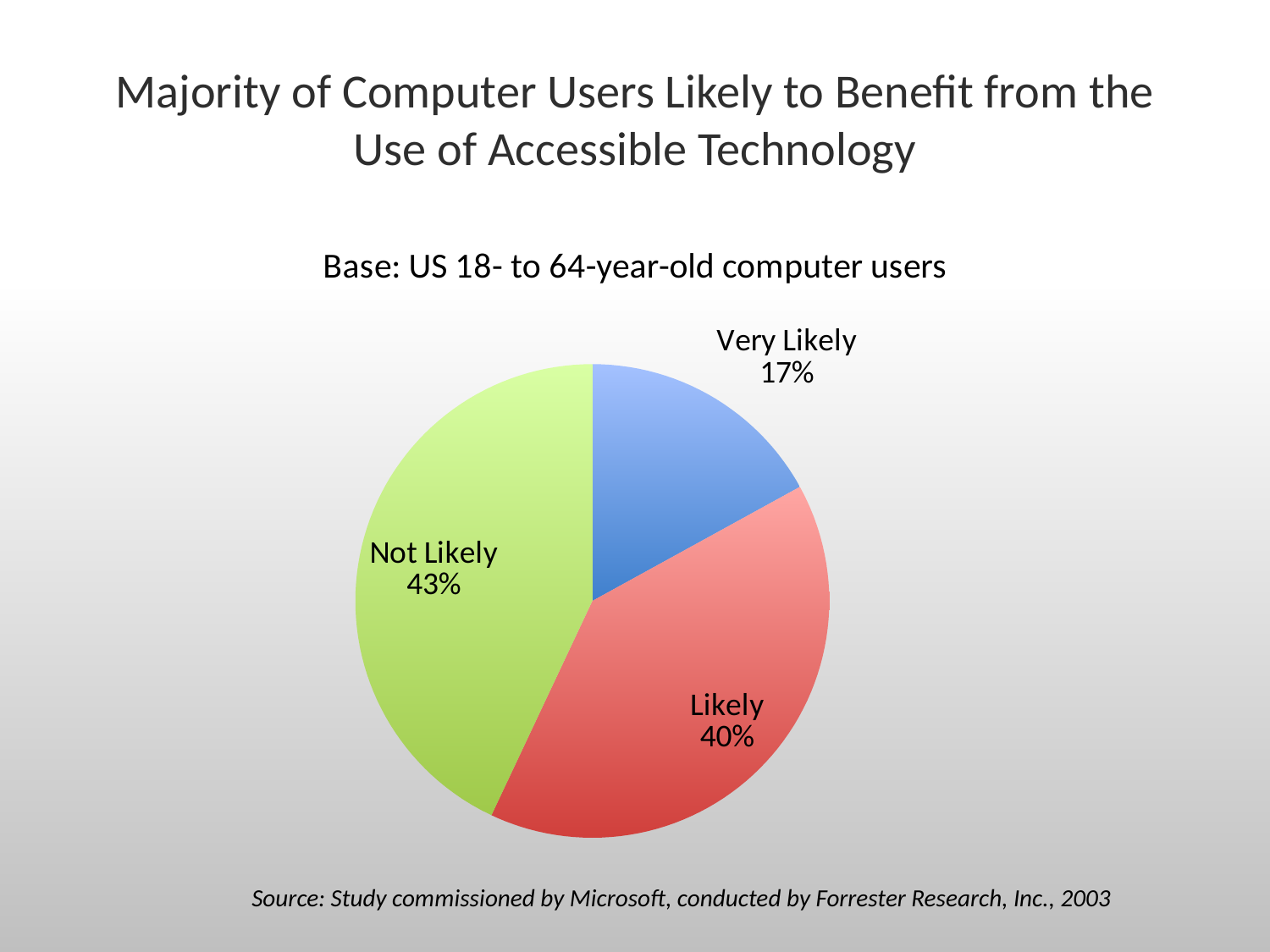
What share of the pie is labelled Not Likely? 43% How many slices does the pie chart have? 3 What share of the pie is labelled Very Likely? 17% What is the difference in percentage points between the Likely and Very Likely slices? 23 What colour is the Not Likely slice? Green Which is larger, the Likely slice or the Very Likely slice? Likely What is the combined share of the Very Likely and Likely slices? 57% What kind of chart is shown on the slide? Pie chart Which category has the largest slice of the pie? Not Likely What is the difference in percentage points between the Not Likely and Very Likely slices? 26 What share of the pie is labelled Likely? 40% Which category has the smallest slice of the pie? Very Likely